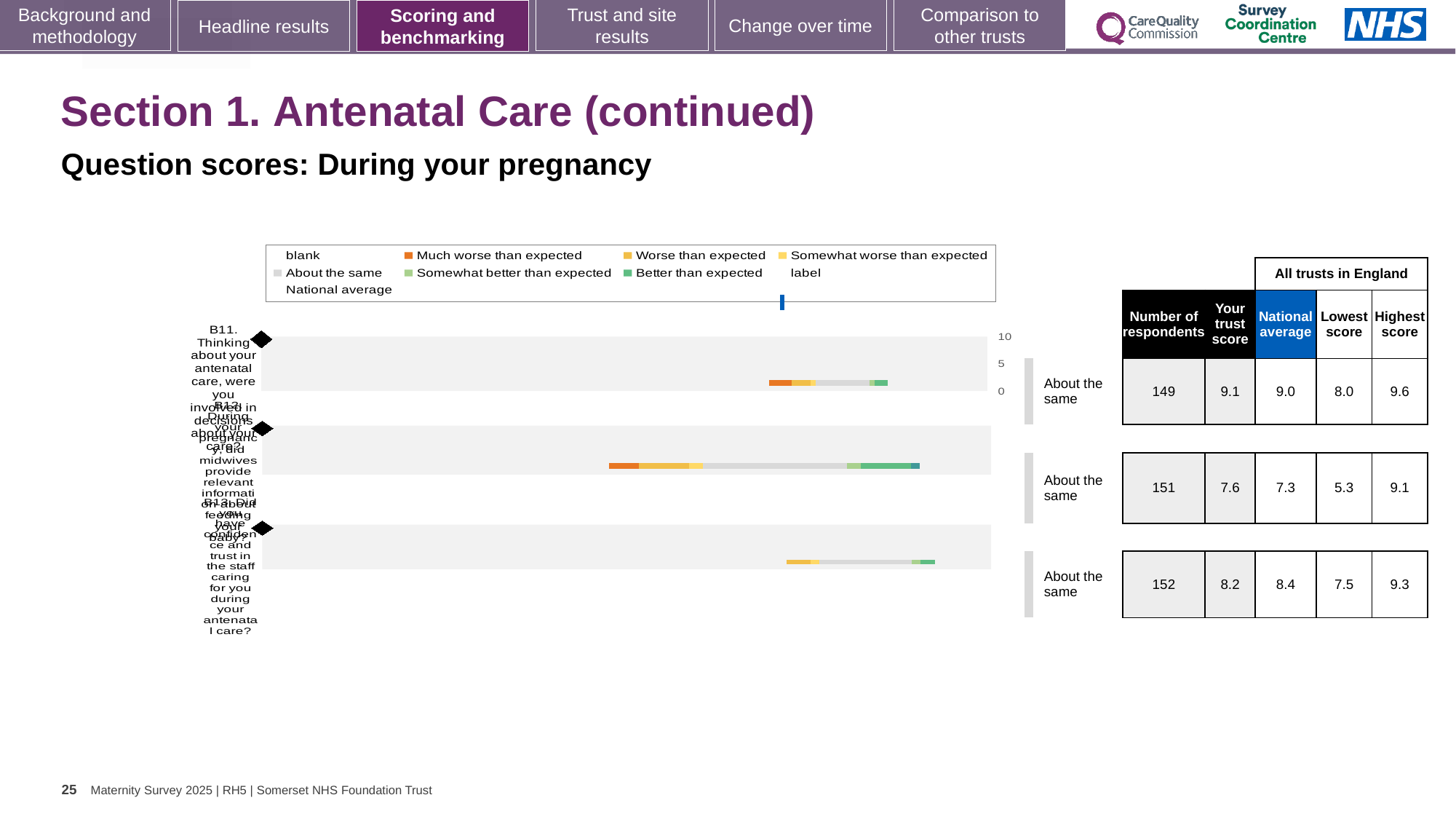
For question B13, which is larger: the trust score or the national average? National average What is the maximum value shown on the score axis of the chart? 10 What is the trust score for question B12 (midwives provide relevant information about feeding your baby)? 7.6 Which question has the highest trust score? B11 What is the number of respondents for question B11 (involved in decisions about your care)? 149 Which question has the lowest trust score? B12 What colour in the legend represents 'Much worse than expected'? Orange How many questions (bars) are plotted in the chart? 3 What is the difference between the highest score and the lowest score for question B12? 3.8 What kind of chart is shown on the slide? Bar chart What is the lowest score across all trusts in England for question B12? 5.3 What is the national average for question B13 (confidence and trust in the staff caring for you)? 8.4